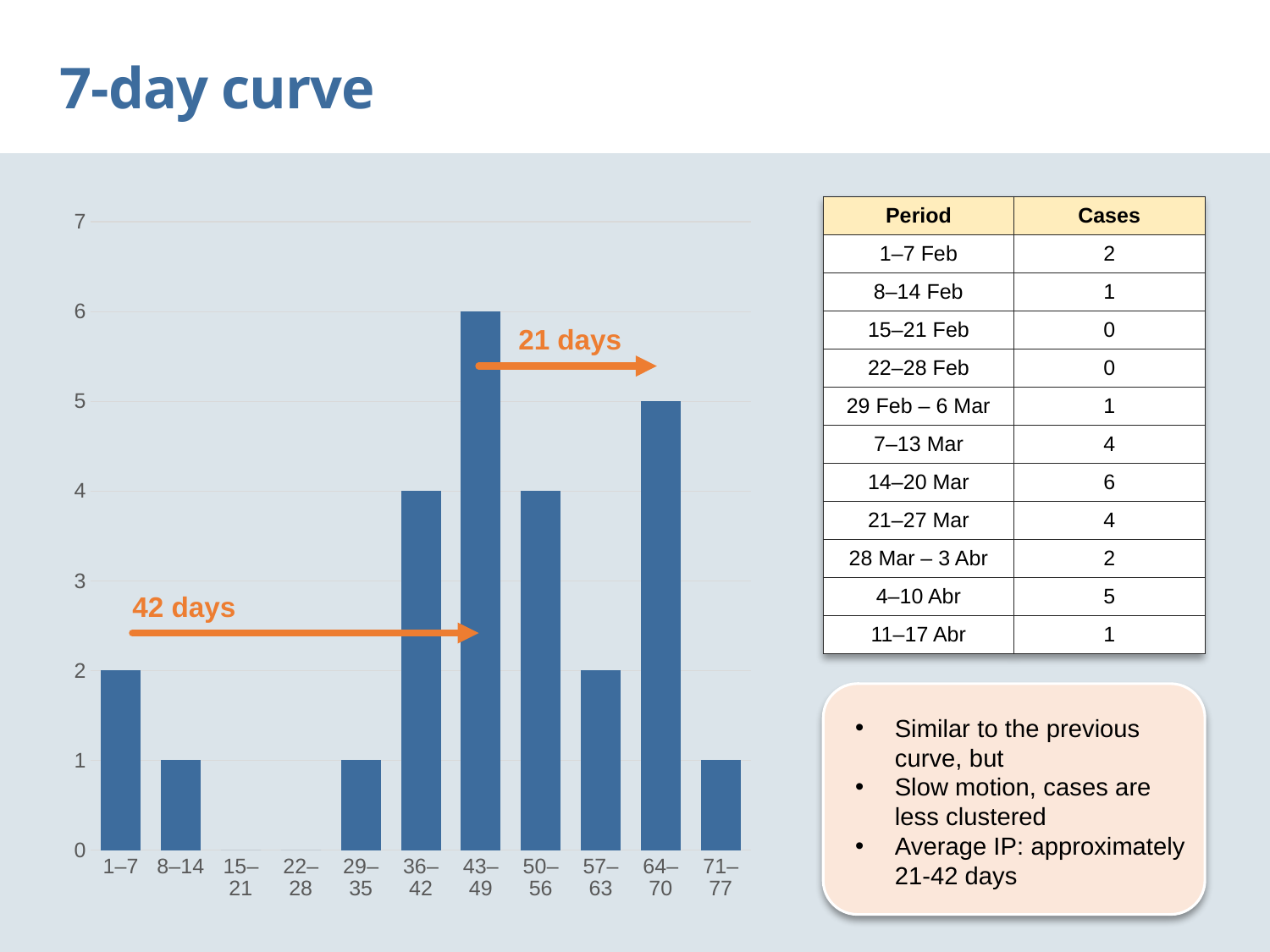
Which categories have a bar value of 0? 15–21 and 22–28 Which category has the highest bar in the chart? 43–49 What is the value of the bar for the 43–49 category? 6 Is the value for the 64–70 category greater or less than 4? greater Which is larger, the bar for 50–56 or the bar for 57–63? 50–56 How many categories are shown on the x axis of the chart? 11 What is the value of the bar for the 64–70 category? 5 What is the difference between the bar for 43–49 and the bar for 64–70? 1 What is the value of the bar for the 1–7 category? 2 What type of chart is shown on the slide? bar chart What is the title of the slide containing the chart? 7-day curve What is the value of the bar for the 36–42 category? 4